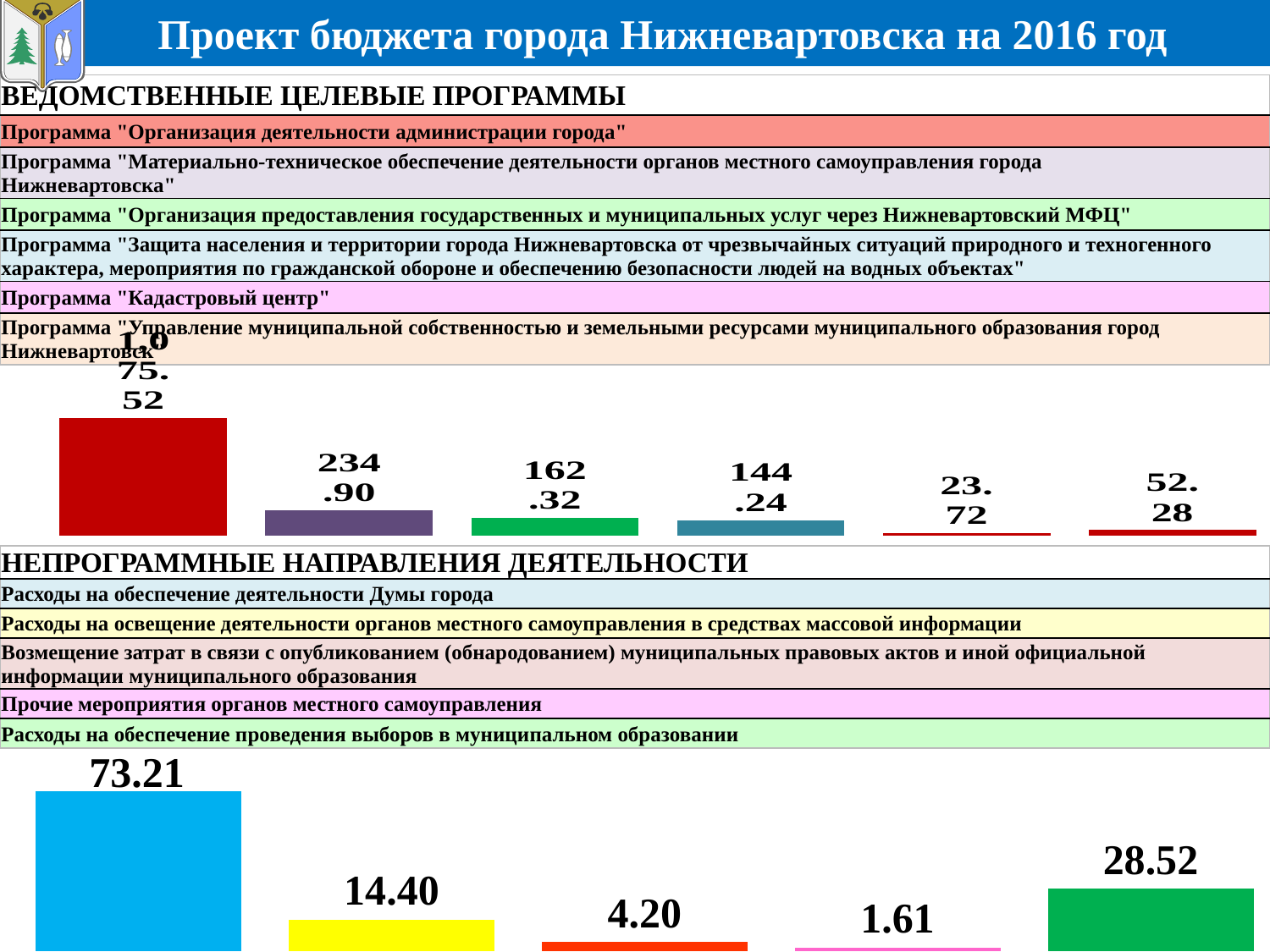
In the bottom chart (Непрограммные направления деятельности), which bar has the lowest value? The fourth bar (1.61) In the bottom chart (Непрограммные направления деятельности), what is the value of the green bar on the right? 28.52 In the top chart (Ведомственные целевые программы), which bar has the lowest value? The fifth bar (23.72) In the top chart (Ведомственные целевые программы), what is the value of the second bar from the left (purple)? 234.90 What type of chart is used in the bottom section (Непрограммные направления деятельности)? Bar chart In the top chart (Ведомственные целевые программы), which is larger: the purple bar or the teal bar? The purple bar (234.90) In the top chart (Ведомственные целевые программы), what is the value of the rightmost bar? 52.28 In the bottom chart (Непрограммные направления деятельности), what is the value of the blue bar? 73.21 In the top chart (Ведомственные целевые программы), what is the difference between the green bar (162.32) and the teal bar (144.24)? 18.08 In the top chart (Ведомственные целевые программы), what is the value of the green bar? 162.32 In the top chart (Ведомственные целевые программы), how many bars are plotted? 6 In the bottom chart (Непрограммные направления деятельности), what is the difference between the yellow bar (14.40) and the red bar (4.20)? 10.20